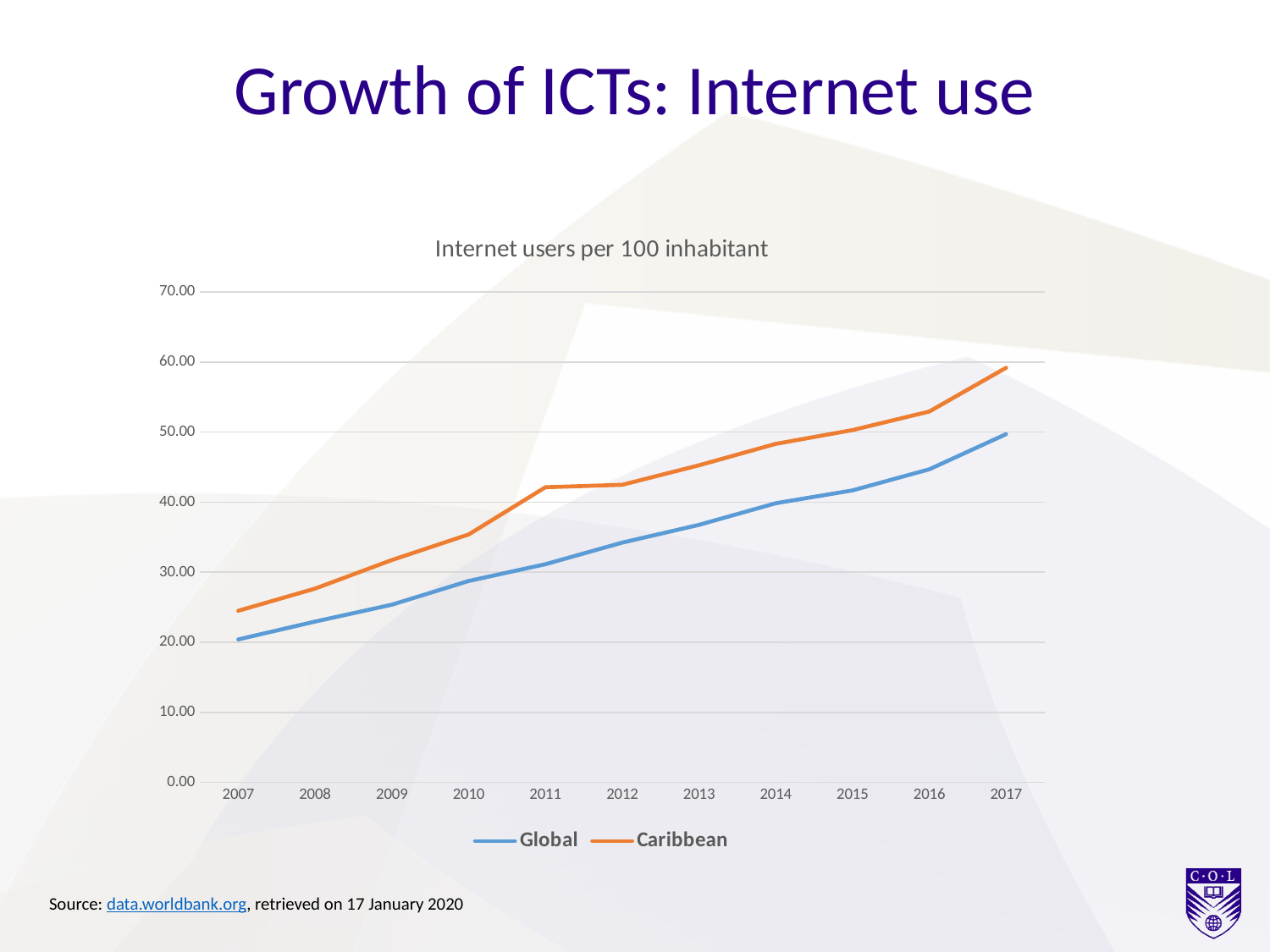
What is the title of the chart? Internet users per 100 inhabitant Do the values for the Global series rise or fall from 2007 to 2017? rise Is the value for Caribbean in 2016 greater or less than 50.00? greater What kind of chart is shown on the slide? line chart How many years are shown on the x axis? 11 Is the value for Global in 2012 greater or less than 40.00? less How many series does the legend list? 2 Which series is shown in orange? Caribbean In which year is the Global series at its lowest? 2007 Is the value for Caribbean in 2017 greater or less than 50.00? greater In which year is the Caribbean series at its highest? 2017 In 2017, which series has the larger value, Global or Caribbean? Caribbean